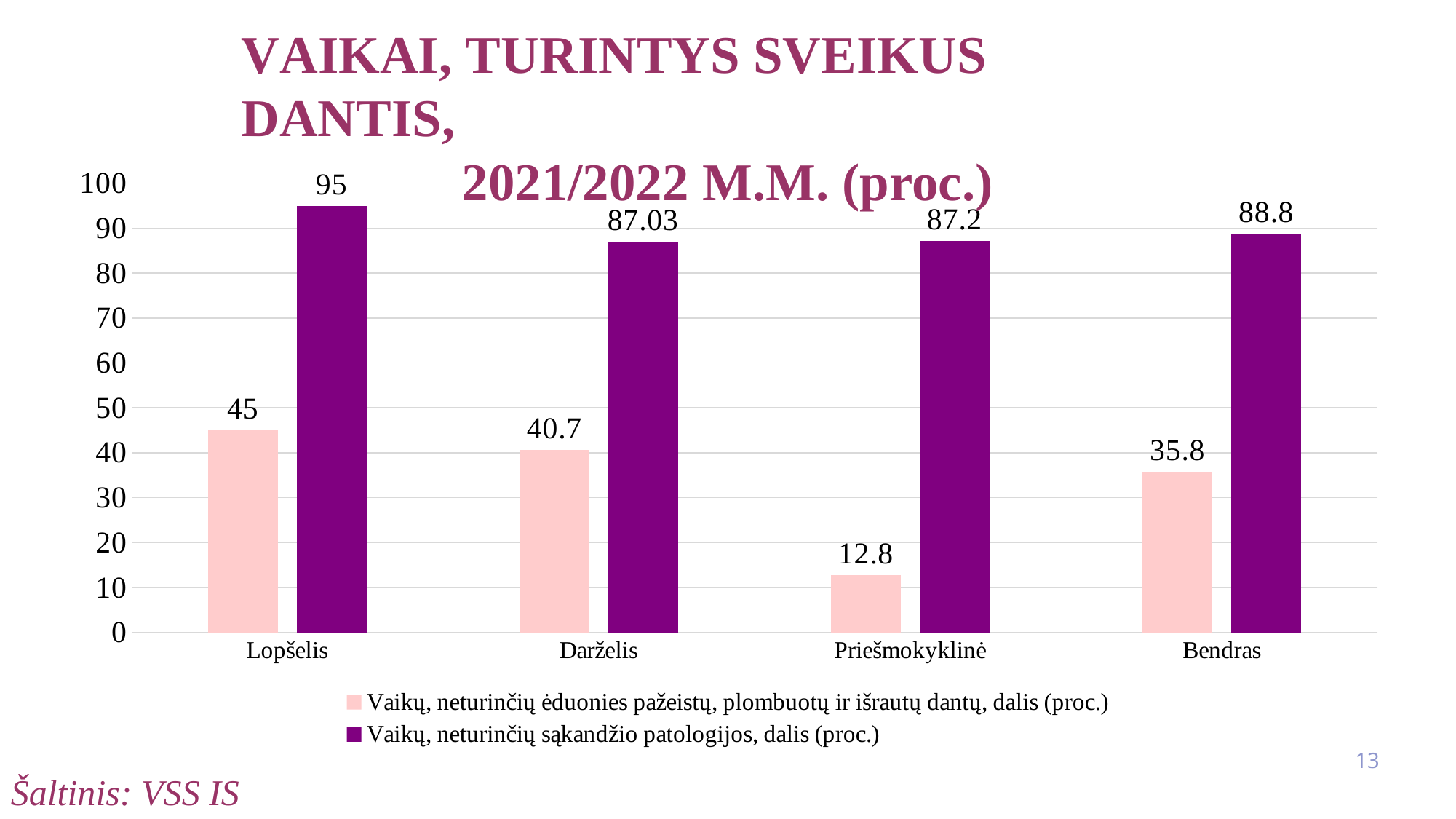
How many categories are shown on the x axis? 4 Which is larger: the Bendras value or the Priešmokyklinė value in the series 'Vaikų, neturinčių sąkandžio patologijos, dalis (proc.)'? Bendras What is the difference between the two series values for Lopšelis? 50 How many series does the legend list? 2 What is the value for Lopšelis in the series 'Vaikų, neturinčių sąkandžio patologijos, dalis (proc.)'? 95 What is the value for Darželis in the series 'Vaikų, neturinčių sąkandžio patologijos, dalis (proc.)'? 87.03 Which category has the highest value in the series 'Vaikų, neturinčių ėduonies pažeistų, plombuotų ir išrautų dantų, dalis (proc.)'? Lopšelis What is the value for Priešmokyklinė in the series 'Vaikų, neturinčių ėduonies pažeistų, plombuotų ir išrautų dantų, dalis (proc.)'? 12.8 Which category has the lowest value in the series 'Vaikų, neturinčių ėduonies pažeistų, plombuotų ir išrautų dantų, dalis (proc.)'? Priešmokyklinė What is the difference between the Lopšelis and Darželis values in the series 'Vaikų, neturinčių ėduonies pažeistų, plombuotų ir išrautų dantų, dalis (proc.)'? 4.3 Which category has the highest value in the series 'Vaikų, neturinčių sąkandžio patologijos, dalis (proc.)'? Lopšelis What is the value for Bendras in the series 'Vaikų, neturinčių ėduonies pažeistų, plombuotų ir išrautų dantų, dalis (proc.)'? 35.8